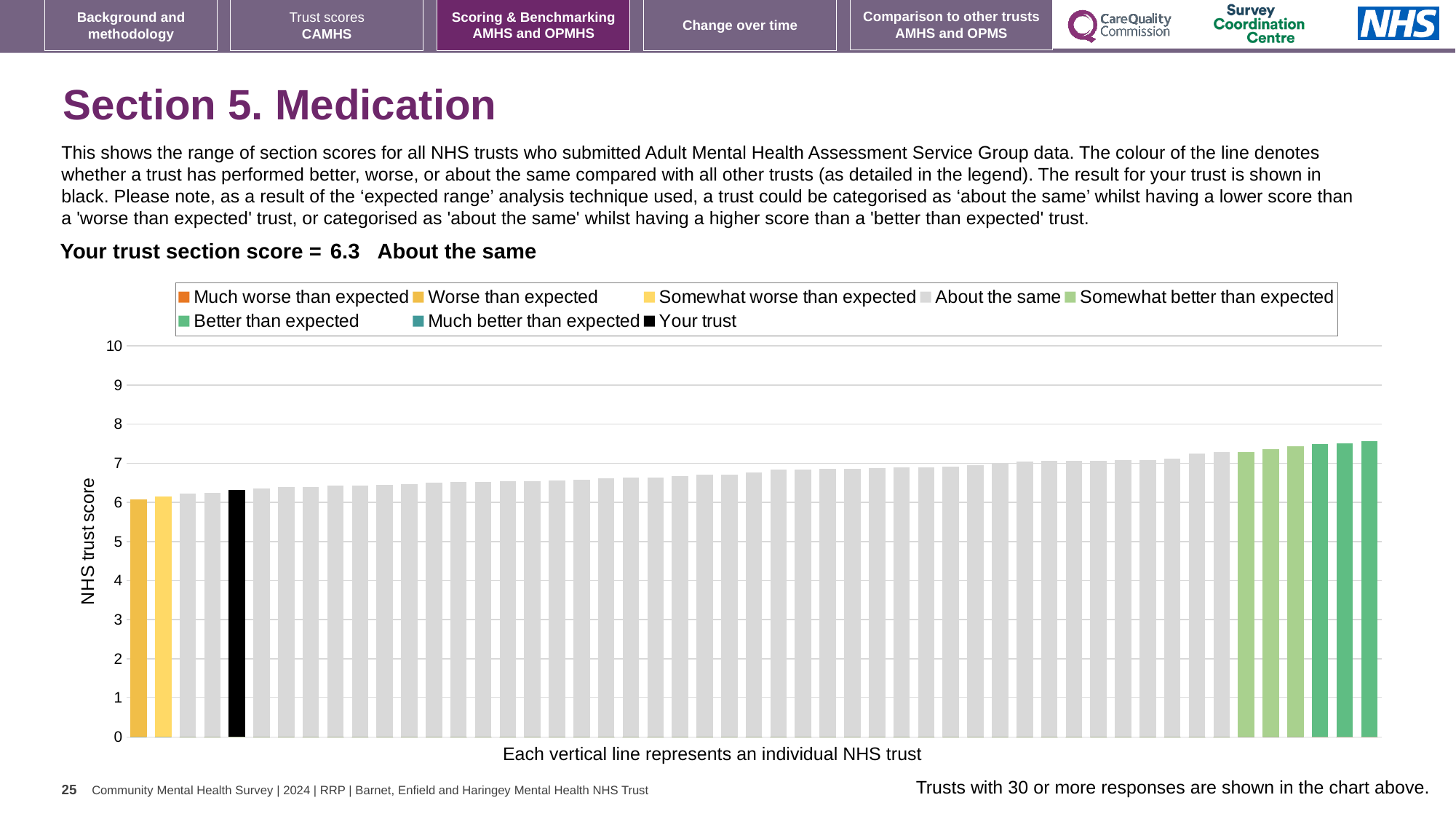
Which category is your trust placed in according to the text above the chart? About the same Is the value for your trust (the black bar) greater or less than 7? less Is the value of the tallest bar in the chart greater or less than 7? greater Is the value of the shortest bar in the chart greater or less than 7? less What is the section score for your trust shown on the slide? 6.3 Which legend category does the shortest bar in the chart belong to? Worse than expected Which legend category does the tallest bar in the chart belong to? Better than expected What kind of chart is shown on the slide? bar chart Do the bar values rise or fall from left to right along the x axis? rise What is the label on the vertical axis of the chart? NHS trust score How many entries does the chart legend list? 8